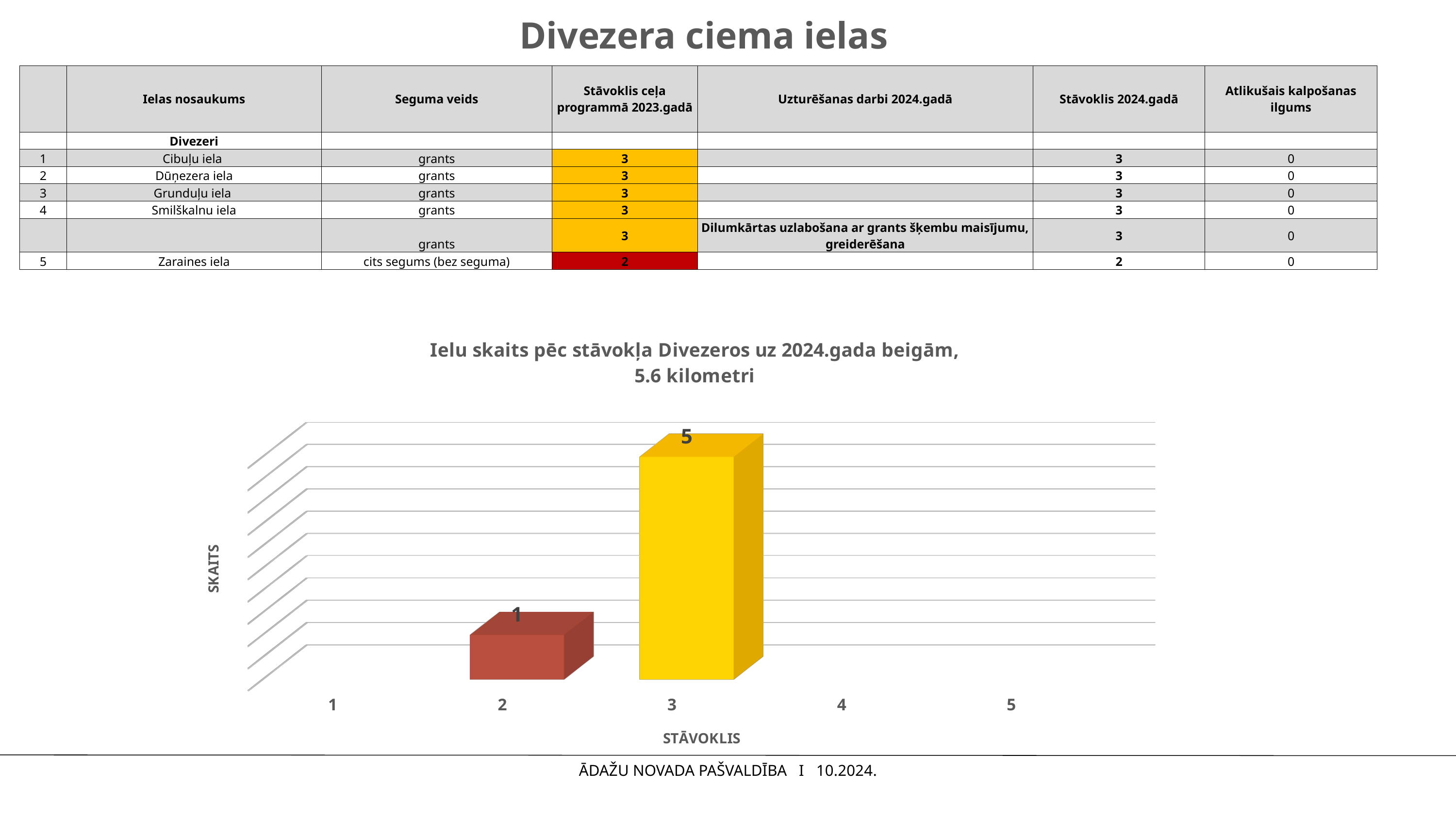
What kind of chart is shown on the slide? bar chart What is the value of the bar for condition (stāvoklis) 3? 5 What is the difference between the bar for condition 3 and the bar for condition 2? 4 What is the label of the x axis of the chart? STĀVOKLIS What is the value of the bar for condition (stāvoklis) 2? 1 Which condition category has the highest bar? 3 Of the categories with a visible bar, which has the lowest value? 2 Which is larger: the bar for condition 2 or the bar for condition 3? condition 3 How many categories on the x axis have a visible bar? 2 What is the title of the chart? Ielu skaits pēc stāvokļa Divezeros uz 2024.gada beigām, 5.6 kilometri How many categories are shown on the x axis of the chart? 5